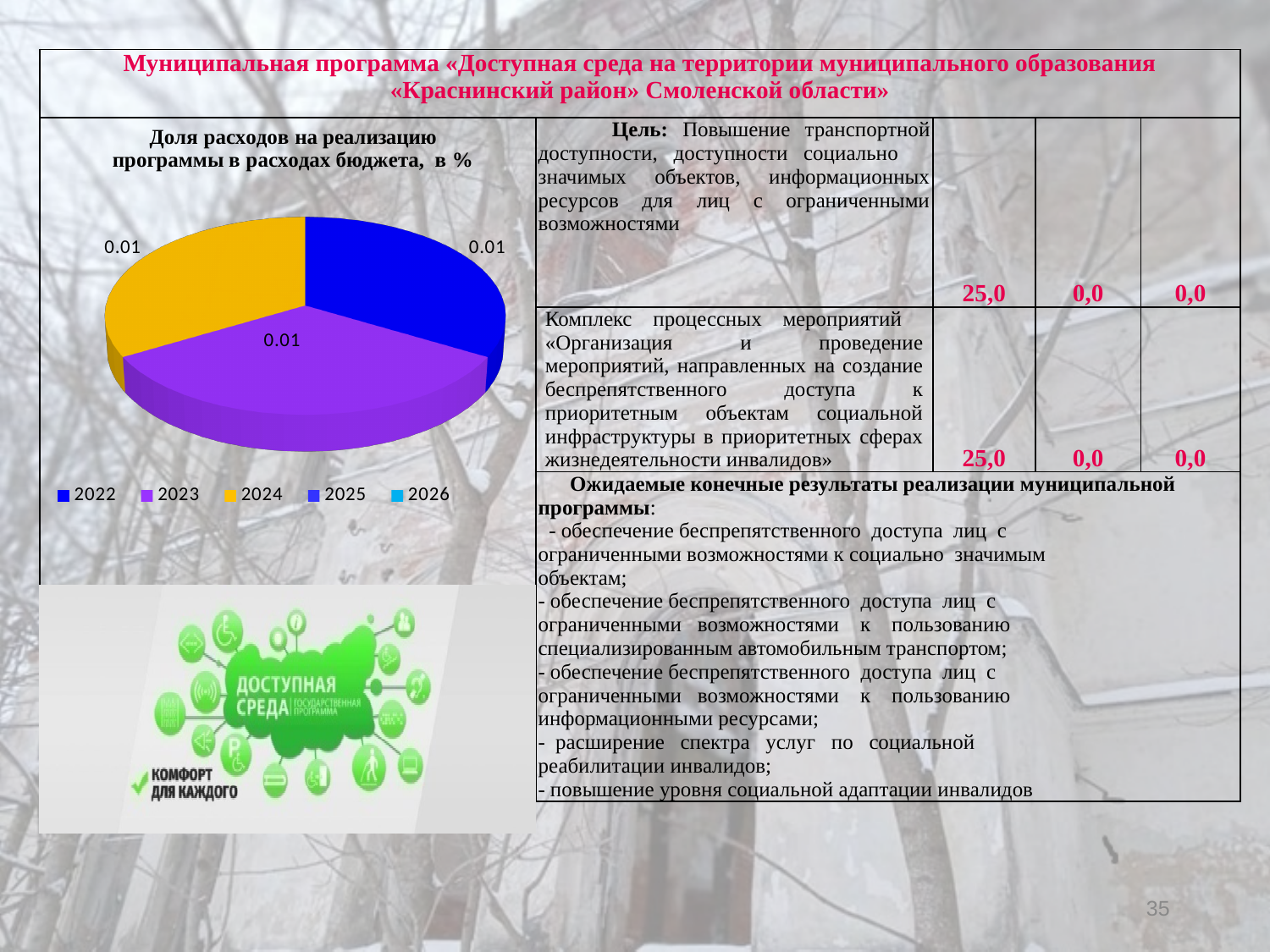
How many slices with data labels are visible in the pie chart? 3 What is the title of the pie chart? Доля расходов на реализацию программы в расходах бюджета, в % What value is labelled on the pie slice for 2022? 0.01 Is the labelled value for 2023 greater or less than 1? less What kind of chart is shown on the slide? pie chart What value is labelled on the pie slice for 2023? 0.01 How many entries does the legend of the pie chart list? 5 Which years are listed in the legend of the pie chart? 2022, 2023, 2024, 2025, 2026 What value is labelled on the pie slice for 2024? 0.01 What colour is the pie slice for 2024? yellow